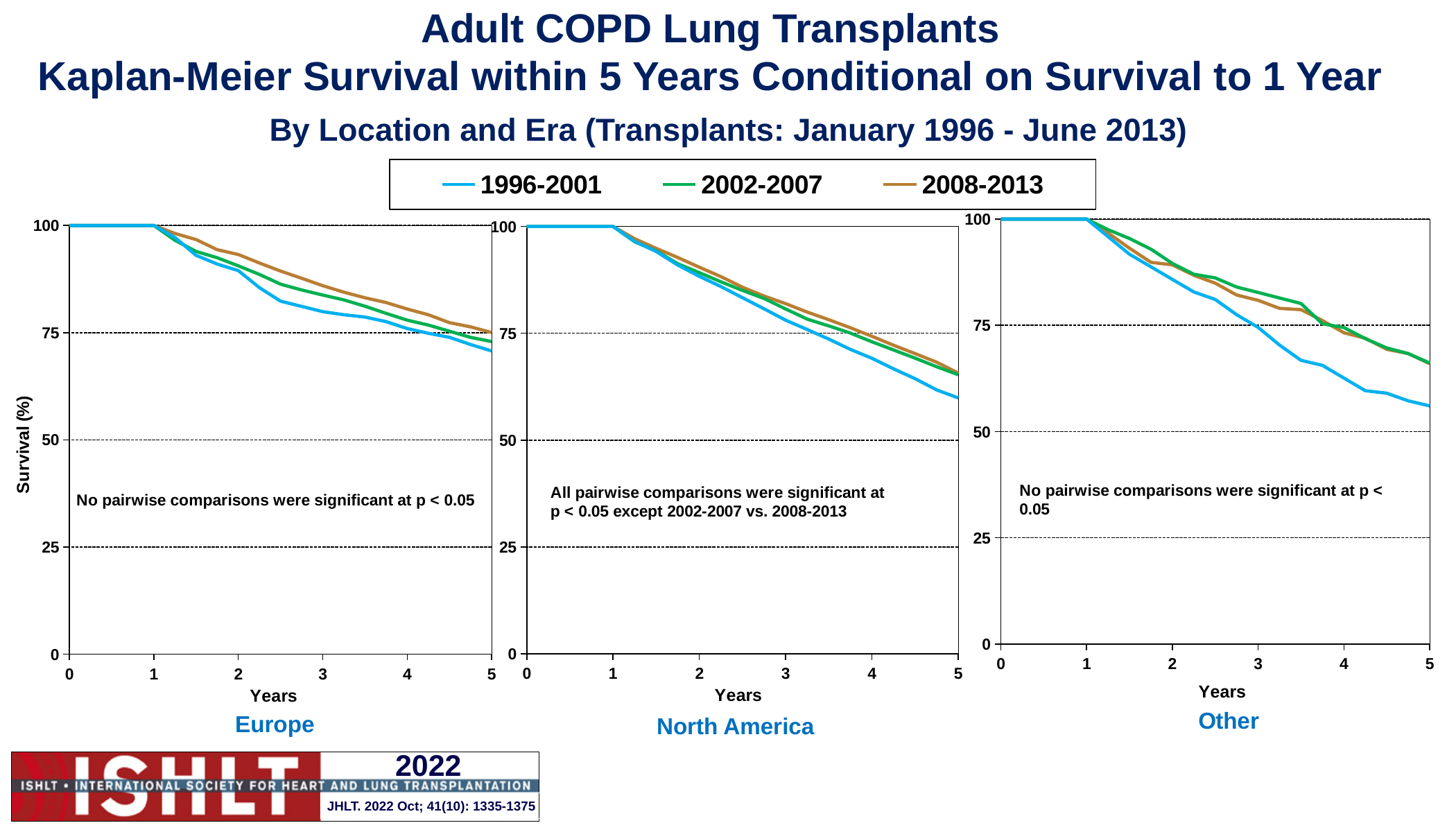
In the North America chart, do the survival values rise or fall as years increase? fall In the Europe chart, at year 3, which is higher: 2008-2013 or 1996-2001? 2008-2013 In the North America chart, which era has the lowest survival at year 5? 1996-2001 In the Other chart, which era has the lowest survival at year 5? 1996-2001 In the Europe chart, what is the survival value for all three eras at year 1? 100 Which era is shown in the brown line according to the legend? 2008-2013 In the Other chart, is the value for 1996-2001 at year 5 greater or less than 50? greater How many series does the legend list? 3 What kind of chart is used for the Europe panel? line chart How many charts are shown on the slide? 3 In the North America chart, is the value for 1996-2001 at year 5 greater or less than 75? less In the Europe chart, is the value for 1996-2001 at year 5 greater or less than 75? less